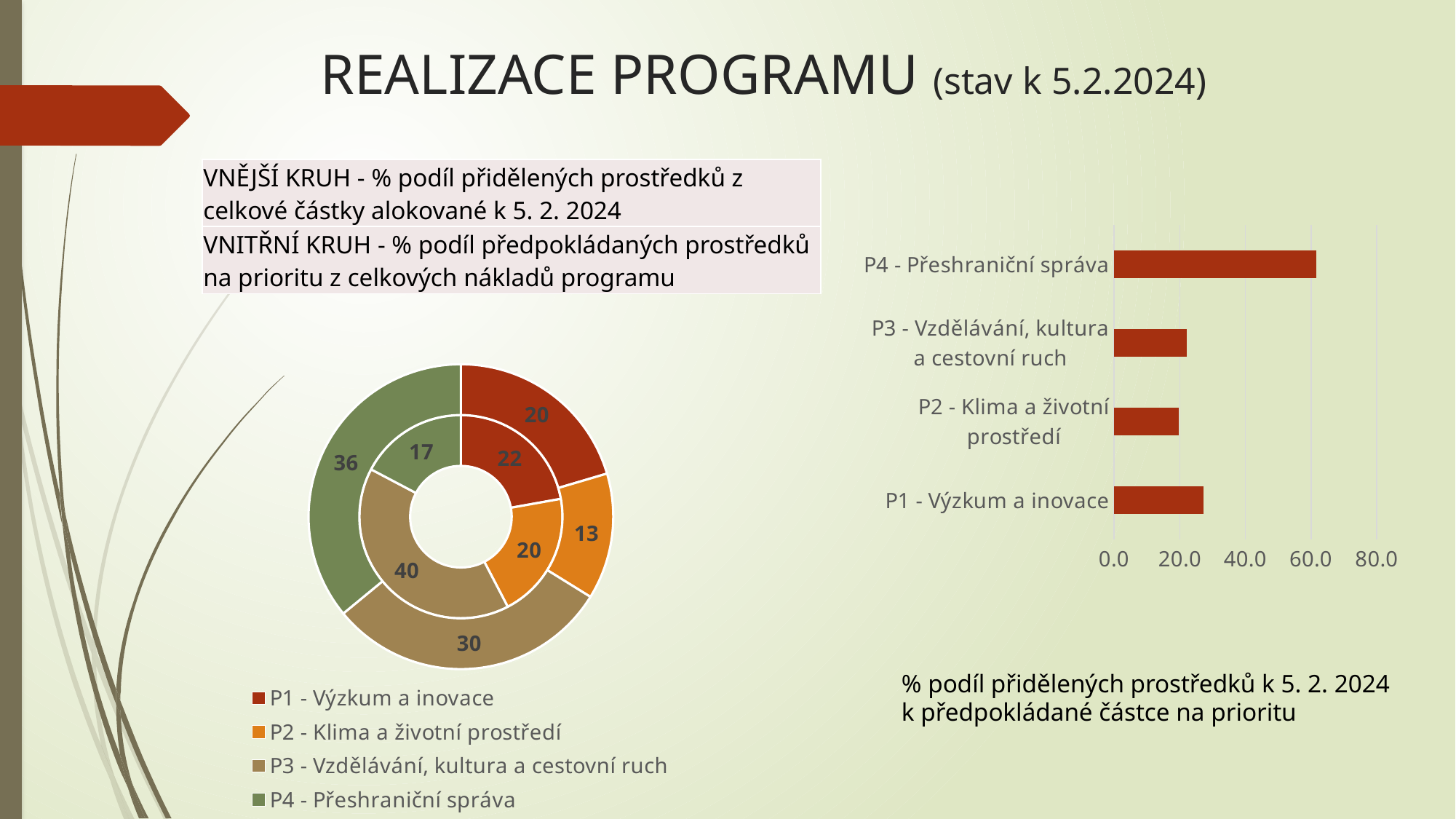
How many categories does the legend of the doughnut chart on the left list? 4 On the bar chart on the right, is the value for P4 - Přeshraniční správa greater or less than 40.0? greater On the doughnut chart on the left, which category has the highest inner-ring value? P3 - Vzdělávání, kultura a cestovní ruch What kind of chart is shown on the right side of the slide? Bar chart On the doughnut chart on the left, which is larger: the inner-ring value for P1 - Výzkum a inovace or the inner-ring value for P4 - Přeshraniční správa? P1 - Výzkum a inovace On the doughnut chart on the left, what is the inner-ring value for P3 - Vzdělávání, kultura a cestovní ruch? 40 On the doughnut chart on the left, what is the difference between the outer-ring values of P4 - Přeshraniční správa and P1 - Výzkum a inovace? 16 On the bar chart on the right, is the value for P1 - Výzkum a inovace greater or less than 40.0? less On the doughnut chart on the left, which category has the lowest outer-ring value? P2 - Klima a životní prostředí On the doughnut chart on the left, what is the outer-ring value for P2 - Klima a životní prostředí? 13 On the doughnut chart on the left, what is the outer-ring value for P4 - Přeshraniční správa? 36 On the bar chart on the right, which category has the highest value? P4 - Přeshraniční správa